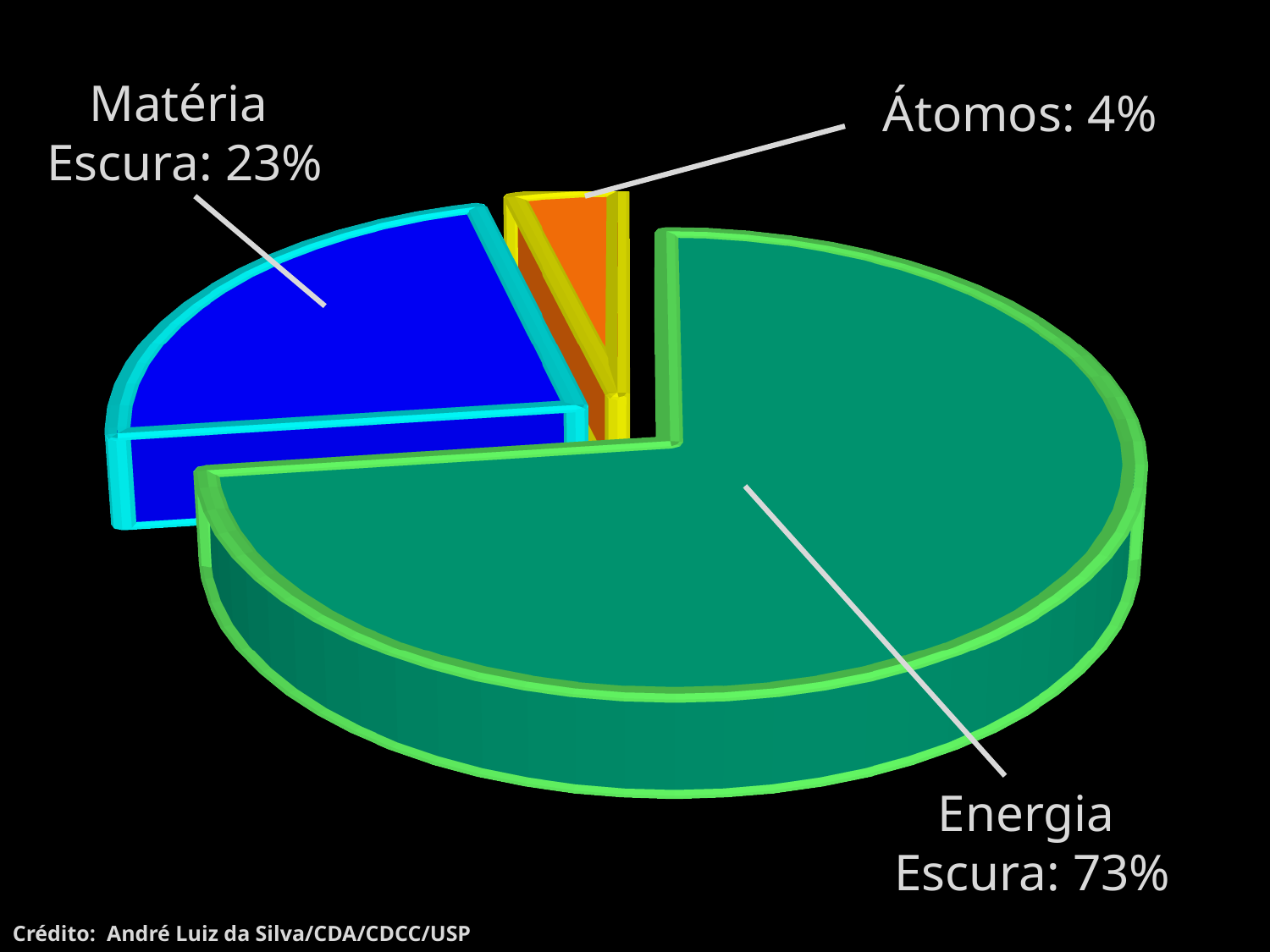
Which is larger, the share for Matéria Escura or the share for Átomos? Matéria Escura Which slice of the pie is the smallest? Átomos How many slices does the pie chart have? 3 What colour is the Matéria Escura slice? Blue Which slice of the pie is the largest? Energia Escura What kind of chart is shown on the slide? Pie chart What colour is the Energia Escura slice? Green What share of the pie does Energia Escura represent? 73% What is the difference in percentage points between Energia Escura and Matéria Escura? 50 What share of the pie does Átomos represent? 4% What is the difference in percentage points between Matéria Escura and Átomos? 19 What share of the pie does Matéria Escura represent? 23%